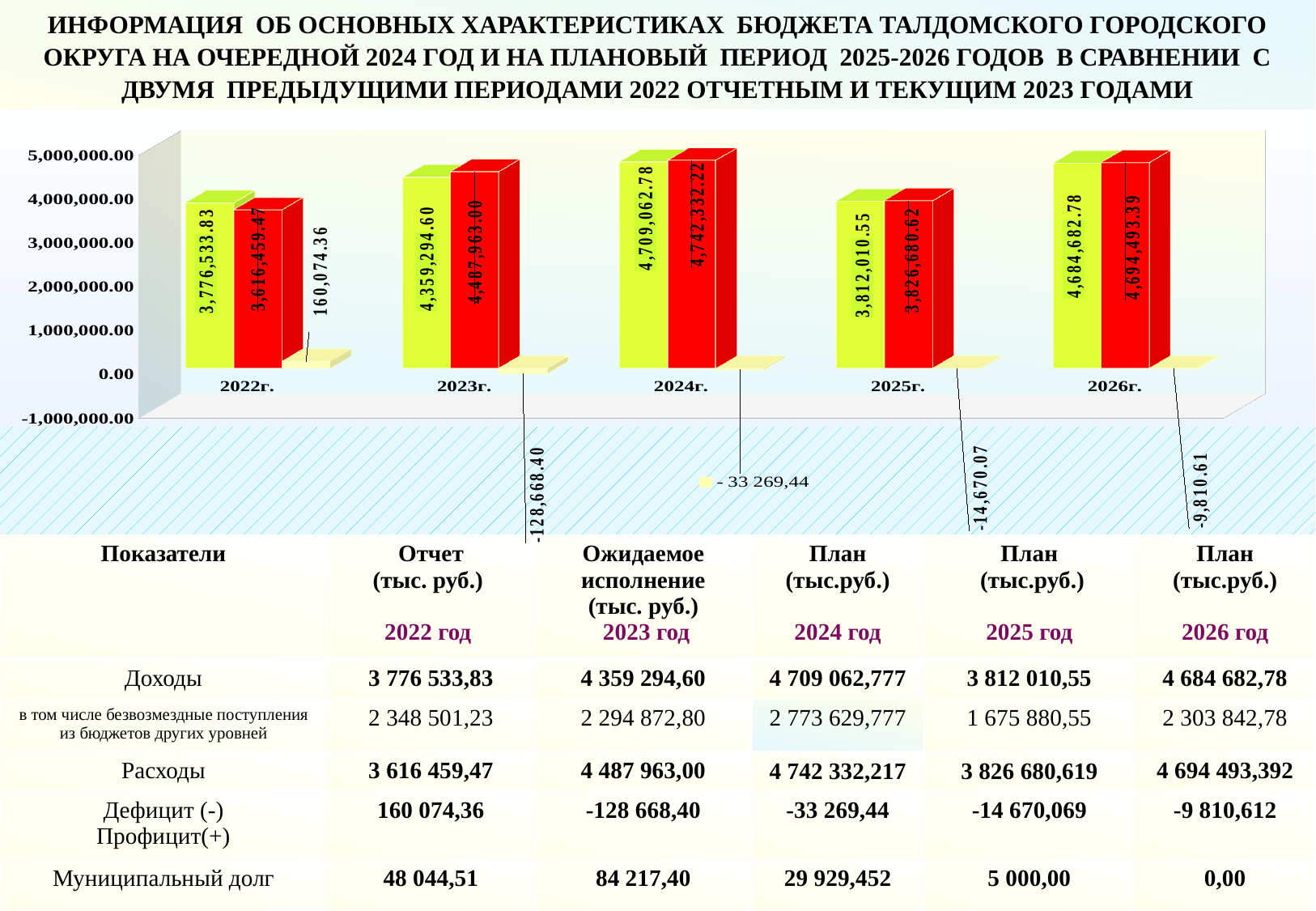
What is the value printed on the green bar for 2022г.? 3,776,533.83 What type of chart is shown on the slide? bar chart What is the value printed on the red bar for 2023г.? 4,487,963.00 In which year is the red bar the lowest? 2022г. How many year categories are shown on the x axis of the chart? 5 What value is shown for the small pale yellow bar for 2022г.? 160,074.36 What is the difference between the red bar and the green bar for 2023г.? 128,668.40 Which is larger for 2022г., the green bar or the red bar? the green bar What is the value printed on the green bar for 2024г.? 4,709,062.78 What value is shown for the pale yellow bar for 2025г.? -14,670.07 In which year is the green bar the highest? 2024г. What is the value printed on the red bar for 2026г.? 4,694,493.39